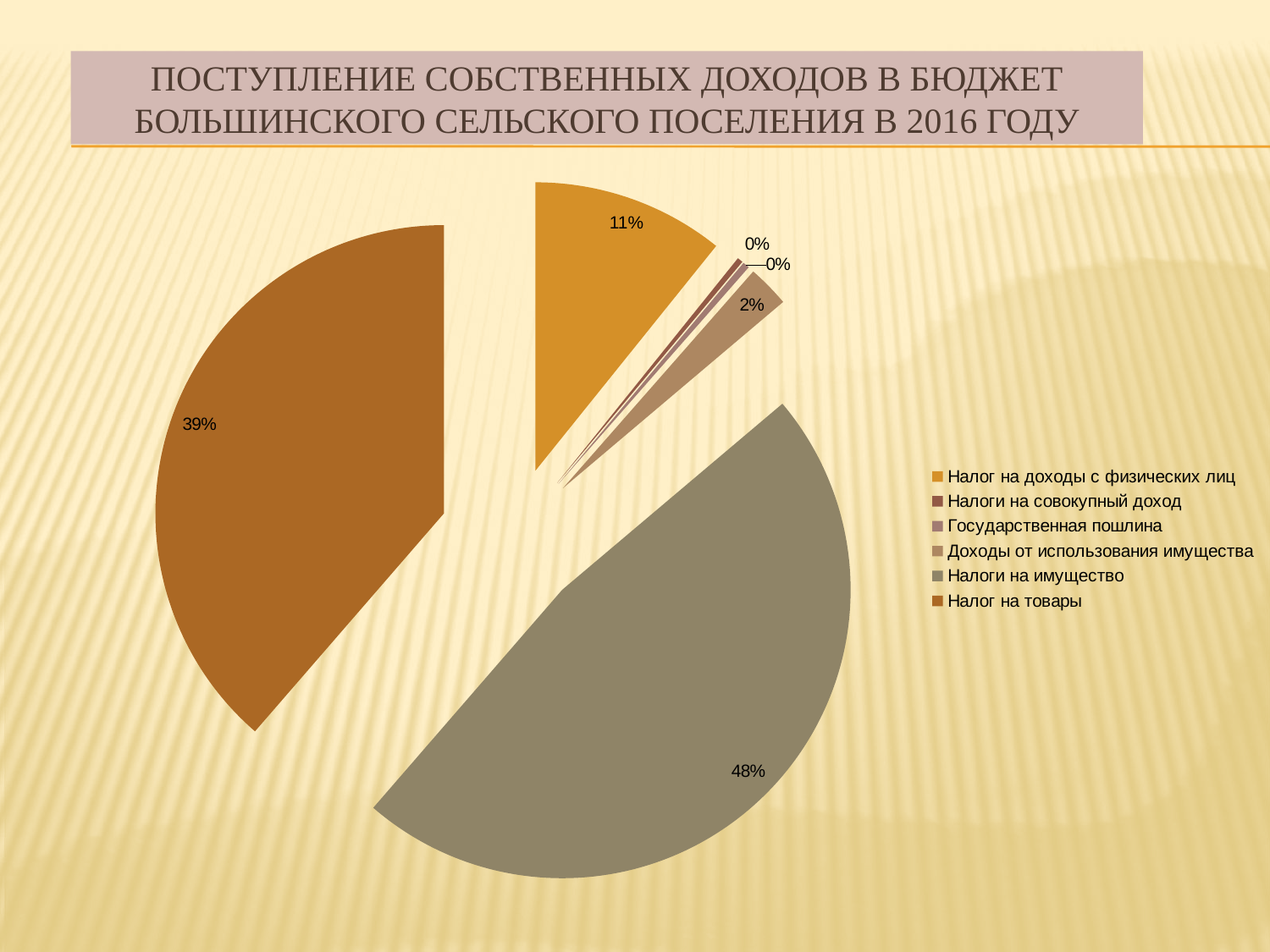
Which is larger: the share for "Налог на товары" or the share for "Налог на доходы с физических лиц"? Налог на товары What is the difference in percentage points between "Налоги на имущество" and "Налог на товары"? 9 Which category has the largest slice of the pie? Налоги на имущество What share of the pie does "Налоги на имущество" have? 48% How many categories does the legend list? 6 What share of the pie does "Налог на доходы с физических лиц" have? 11% What share of the pie does "Налог на товары" have? 39% What kind of chart is shown on the slide? Pie chart What is the combined share of "Налоги на имущество" and "Налог на товары"? 87% What year does the chart title refer to? 2016 Which two categories are labelled 0% on the chart? Налоги на совокупный доход and Государственная пошлина